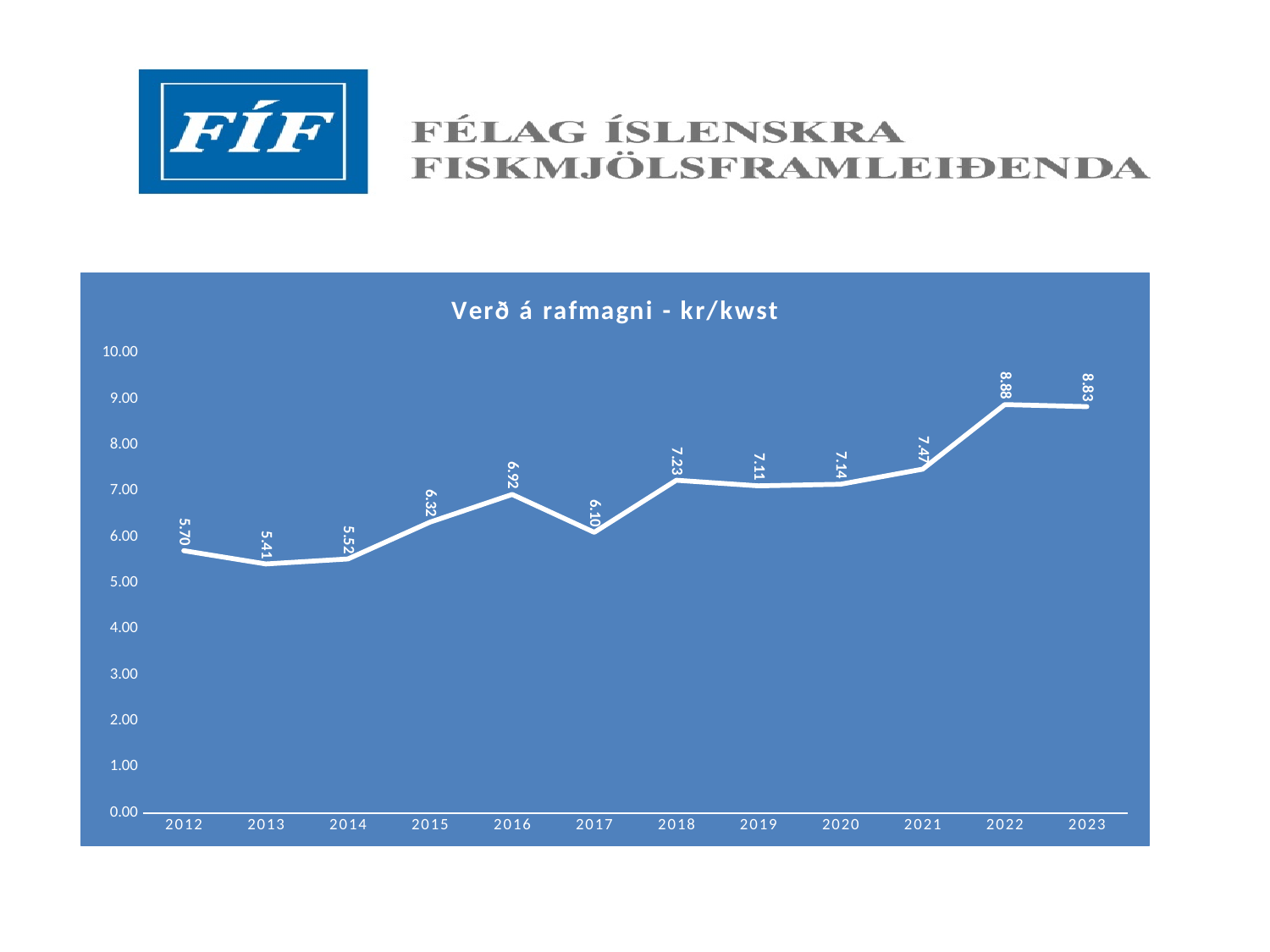
What is the difference between the values for 2022 and 2012? 3.18 Which is larger, the value for 2018 or the value for 2019? 2018 What is the value for 2012? 5.70 Which year has the lowest value? 2013 What is the difference between the values for 2017 and 2016? 0.82 What is the title of the chart? Verð á rafmagni - kr/kwst How many years are plotted on the chart? 12 What kind of chart is shown? line chart What is the value for 2016? 6.92 Is the value for 2015 greater or less than 7.00? less Which year has the highest value? 2022 What is the value for 2021? 7.47